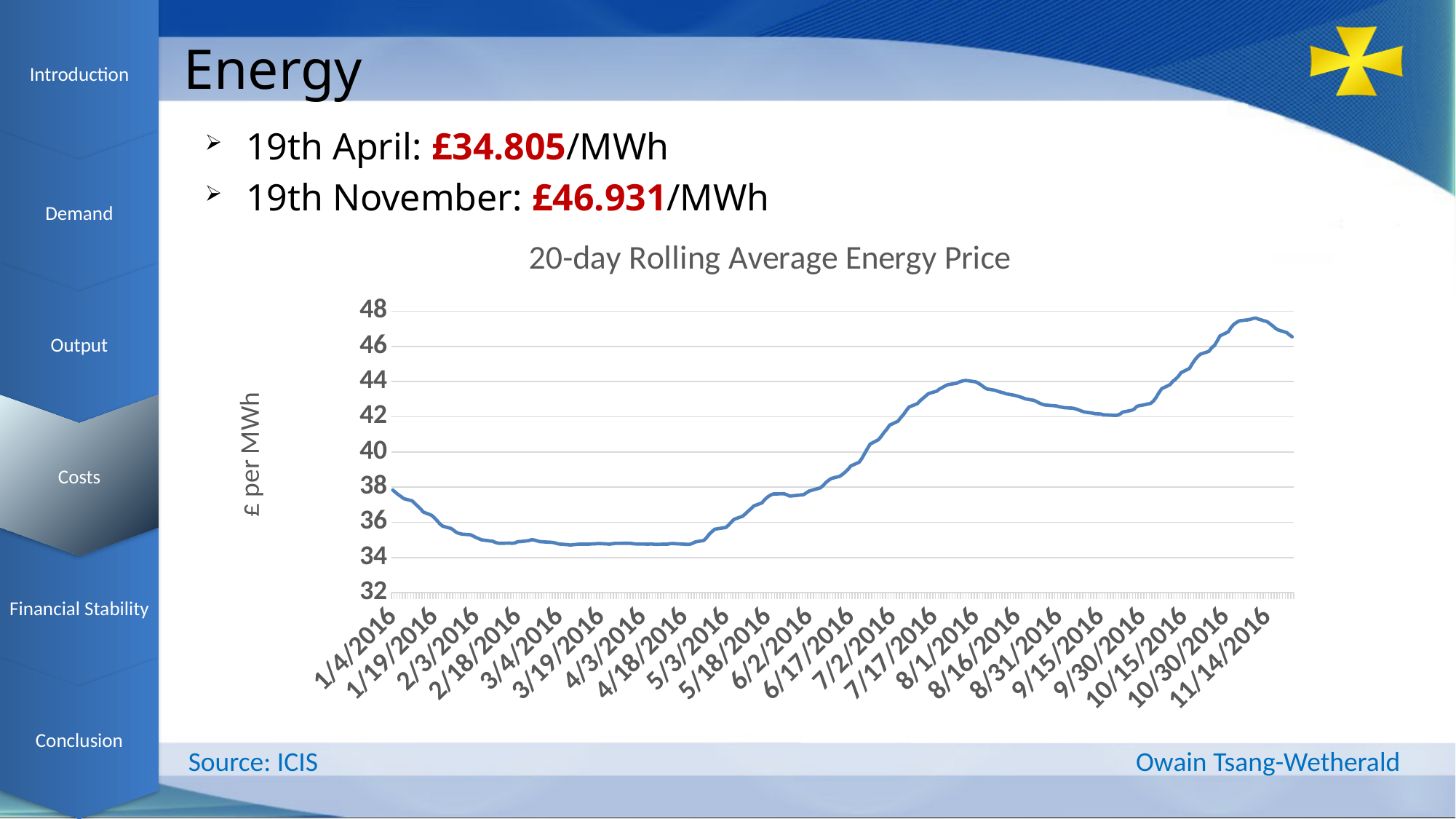
Does the line rise or fall between 1/4/2016 and 3/4/2016? fall Is the value for 7/2/2016 greater or less than 38? greater Is the value for 10/30/2016 greater or less than 46? greater Is the value for 5/18/2016 greater or less than 38? less Which is larger, the value for 10/30/2016 or the value for 3/4/2016? 10/30/2016 What is the label on the vertical axis of the chart? £ per MWh Does the line rise or fall between 5/3/2016 and 8/1/2016? rise What is the title of the chart? 20-day Rolling Average Energy Price What kind of chart is shown on the slide? line chart